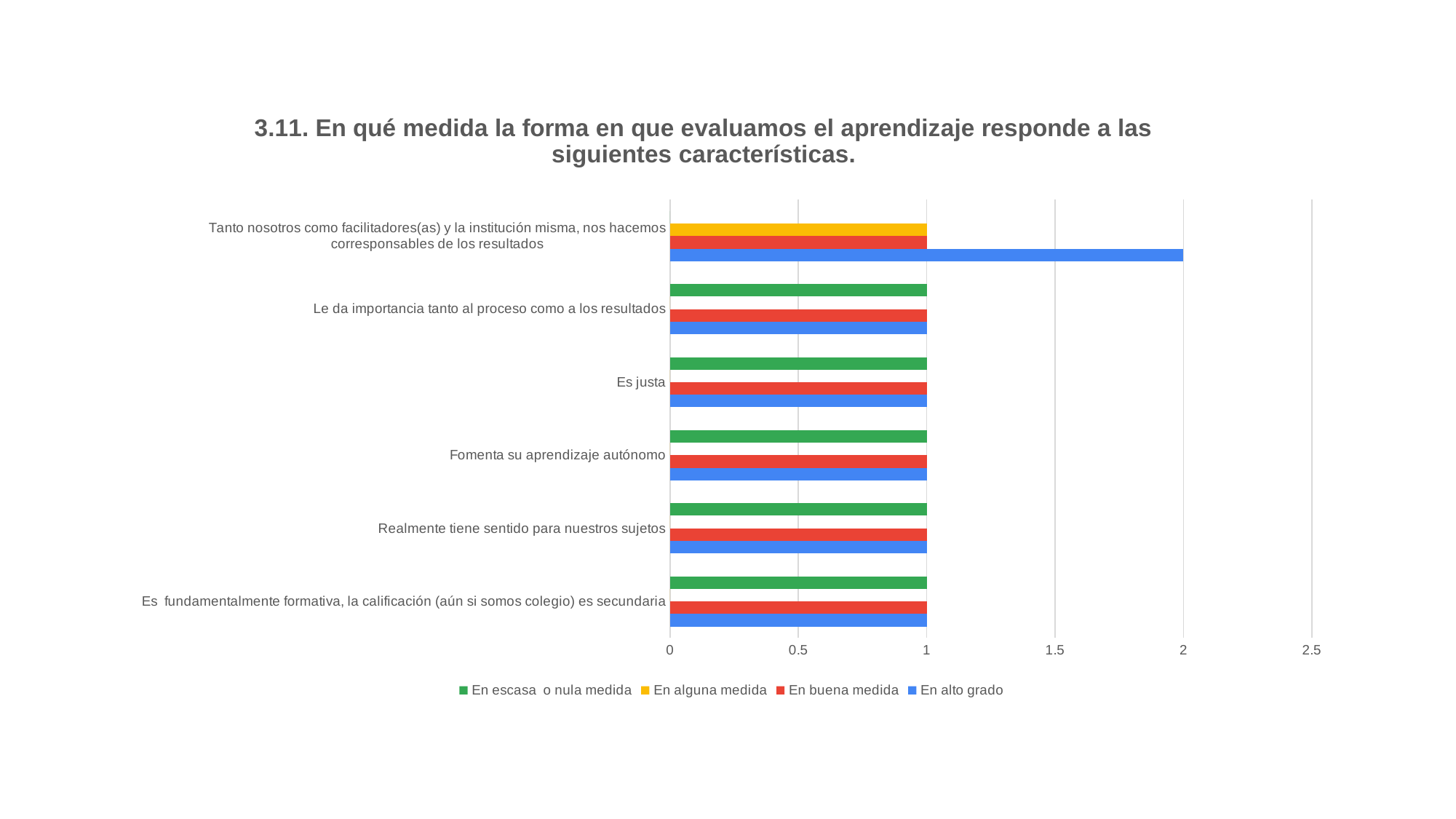
How many series does the legend list? 4 What colour represents the 'En alto grado' series in the chart? blue Is the 'En alto grado' value for 'Tanto nosotros como facilitadores(as) y la institución misma, nos hacemos corresponsables de los resultados' greater or less than 1.5? greater What is the difference between the 'En alto grado' value and the 'En buena medida' value for 'Tanto nosotros como facilitadores(as) y la institución misma, nos hacemos corresponsables de los resultados'? 1 How many categories are listed on the vertical axis of the chart? 6 What is the value of 'En escasa o nula medida' for 'Es justa'? 1 What is the value of 'En alguna medida' for 'Tanto nosotros como facilitadores(as) y la institución misma, nos hacemos corresponsables de los resultados'? 1 Which category is the only one with a bar for the 'En alguna medida' series? Tanto nosotros como facilitadores(as) y la institución misma, nos hacemos corresponsables de los resultados Which is larger: the 'En alto grado' value for 'Tanto nosotros como facilitadores(as) y la institución misma, nos hacemos corresponsables de los resultados' or the 'En alto grado' value for 'Es justa'? Tanto nosotros como facilitadores(as) y la institución misma, nos hacemos corresponsables de los resultados What kind of chart is shown on the slide? bar chart Which category has the highest value for the 'En alto grado' series? Tanto nosotros como facilitadores(as) y la institución misma, nos hacemos corresponsables de los resultados What is the value of 'En alto grado' for 'Tanto nosotros como facilitadores(as) y la institución misma, nos hacemos corresponsables de los resultados'? 2